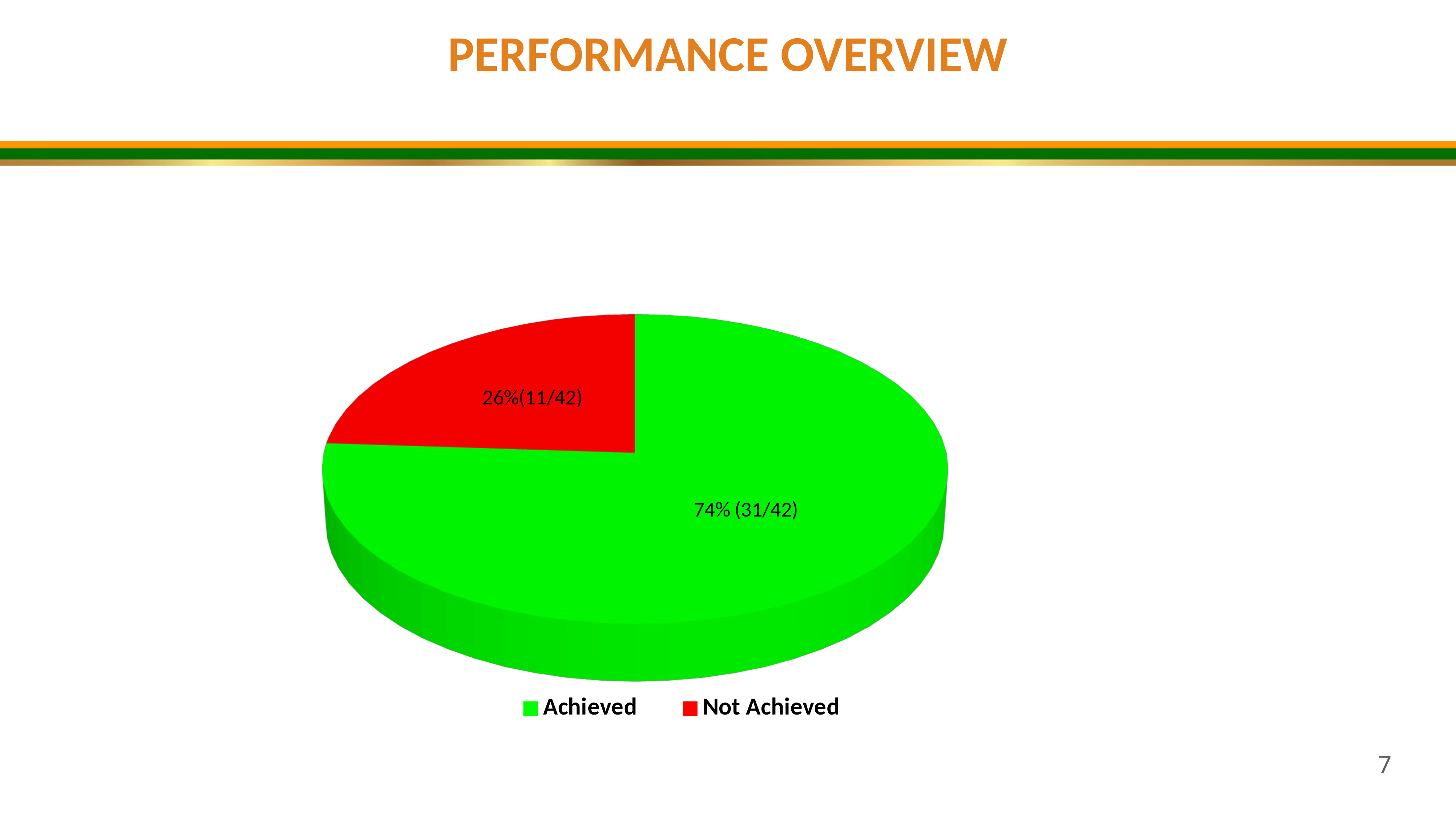
What percentage of the pie is labelled for the Achieved slice? 74% What colour is the Not Achieved slice? Red How many entries does the legend list? 2 What kind of chart is shown on the slide? Pie chart What fraction is shown in the data label for the Not Achieved slice? 11/42 Which slice is the largest in the pie chart? Achieved What is the difference in percentage points between the Achieved and Not Achieved slices? 48 What fraction is shown in the data label for the Achieved slice? 31/42 How many slices does the pie chart have? 2 Which slice is the smallest in the pie chart? Not Achieved What percentage of the pie is labelled for the Not Achieved slice? 26% Which is larger, the Achieved slice or the Not Achieved slice? Achieved